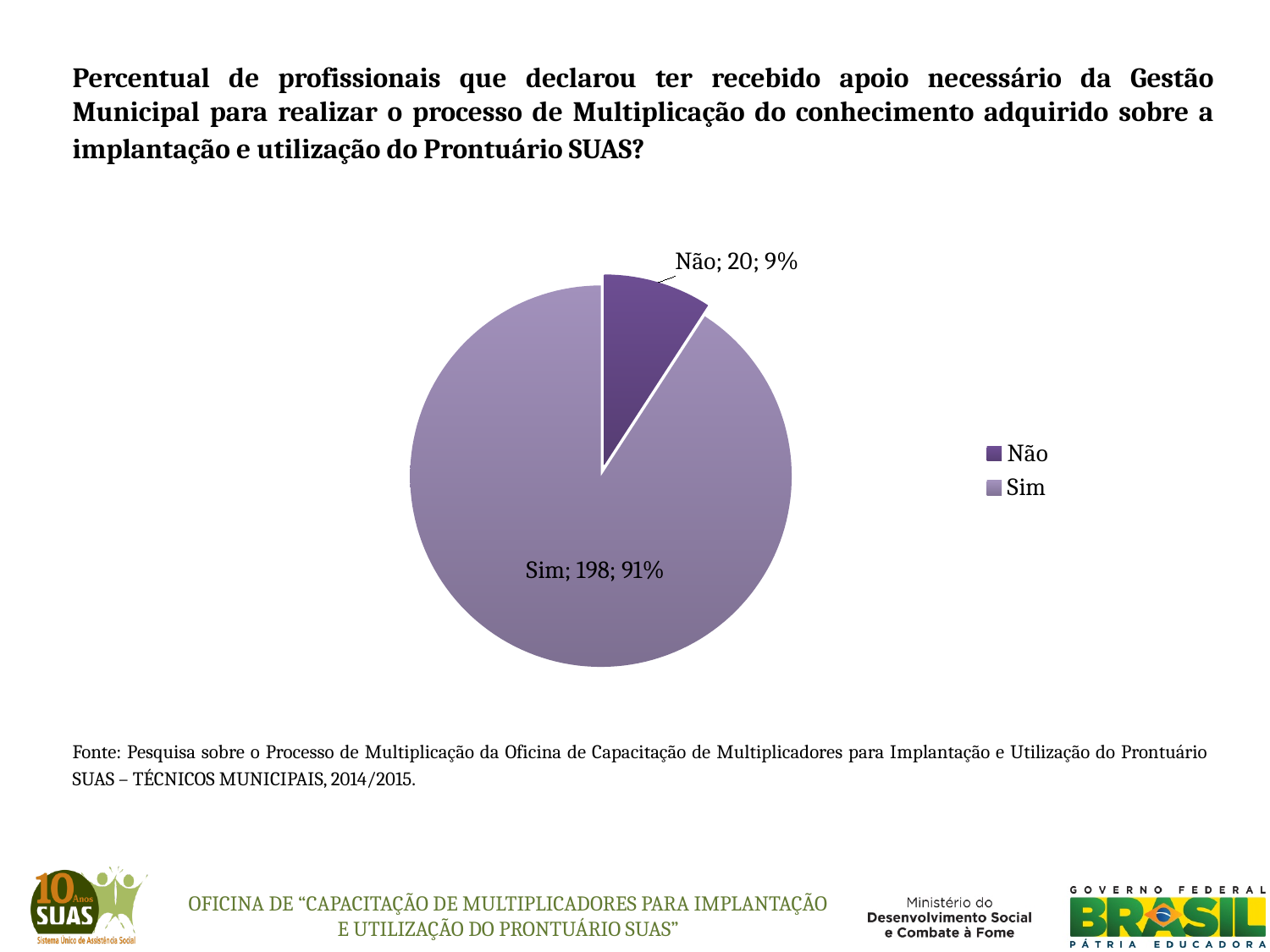
What percentage of the pie does the "Sim" slice represent? 91% How many slices does the pie chart have? 2 What is the count shown for the "Sim" slice? 198 What kind of chart is shown on the slide? pie chart Which slice is the smallest? Não What is the total count across both slices? 218 What is the count shown for the "Não" slice? 20 What percentage of the pie does the "Não" slice represent? 9% Which slice is the largest? Sim Which legend entry is shown in the darker purple colour? Não How many entries does the legend list? 2 What is the difference between the counts for "Sim" and "Não"? 178